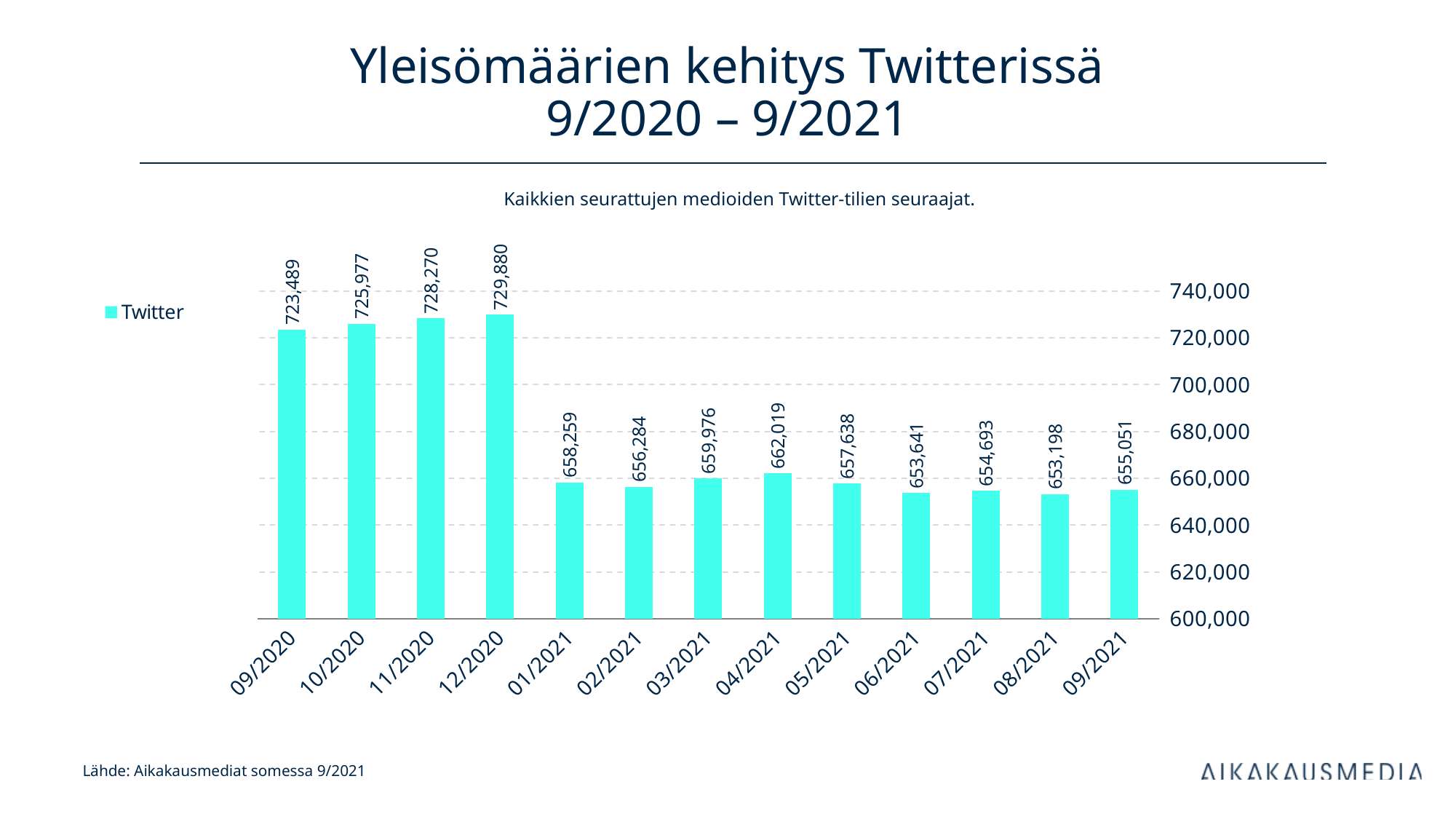
What is the value for 09/2021? 655,051 How many series does the legend list? 1 How many months are shown on the x axis? 13 Which month has the lowest value? 08/2021 What is the value for 12/2020? 729,880 Which is larger, the value for 04/2021 or the value for 06/2021? 04/2021 What is the difference between the values for 12/2020 and 01/2021? 71,621 What kind of chart is shown on the slide? bar chart Is the value for 11/2020 greater or less than 700,000? greater What is the value for 01/2021? 658,259 What is the difference between the values for 09/2020 and 09/2021? 68,438 Which month has the highest value? 12/2020